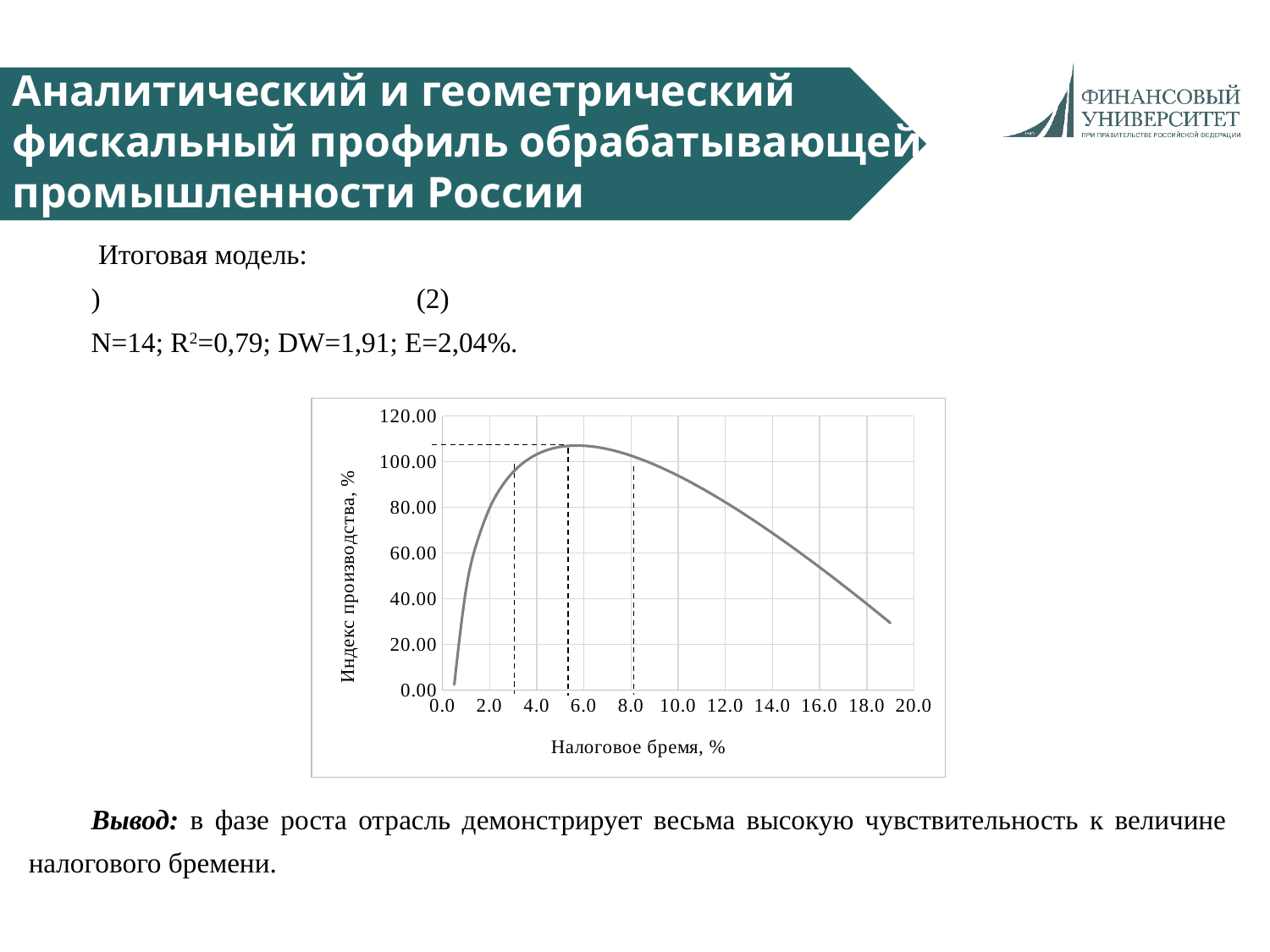
Is the value of the curve at a tax burden of 10.0 greater or less than 80.00? greater Does the curve rise or fall as the tax burden increases from 0.0 to 4.0? rise What is the label of the y axis of the chart? Индекс производства, % Which is larger: the value of the curve at a tax burden of 6.0 or at 14.0? 6.0 What kind of chart is shown on the slide? line chart Is the peak value of the curve greater or less than 100.00? greater Does the curve rise or fall as the tax burden increases from 10.0 to 18.0? fall What is the label of the x axis of the chart? Налоговое бремя, % What is the highest tick value shown on the y axis? 120.00 Is the value of the curve at a tax burden of 4.0 greater or less than 80.00? greater